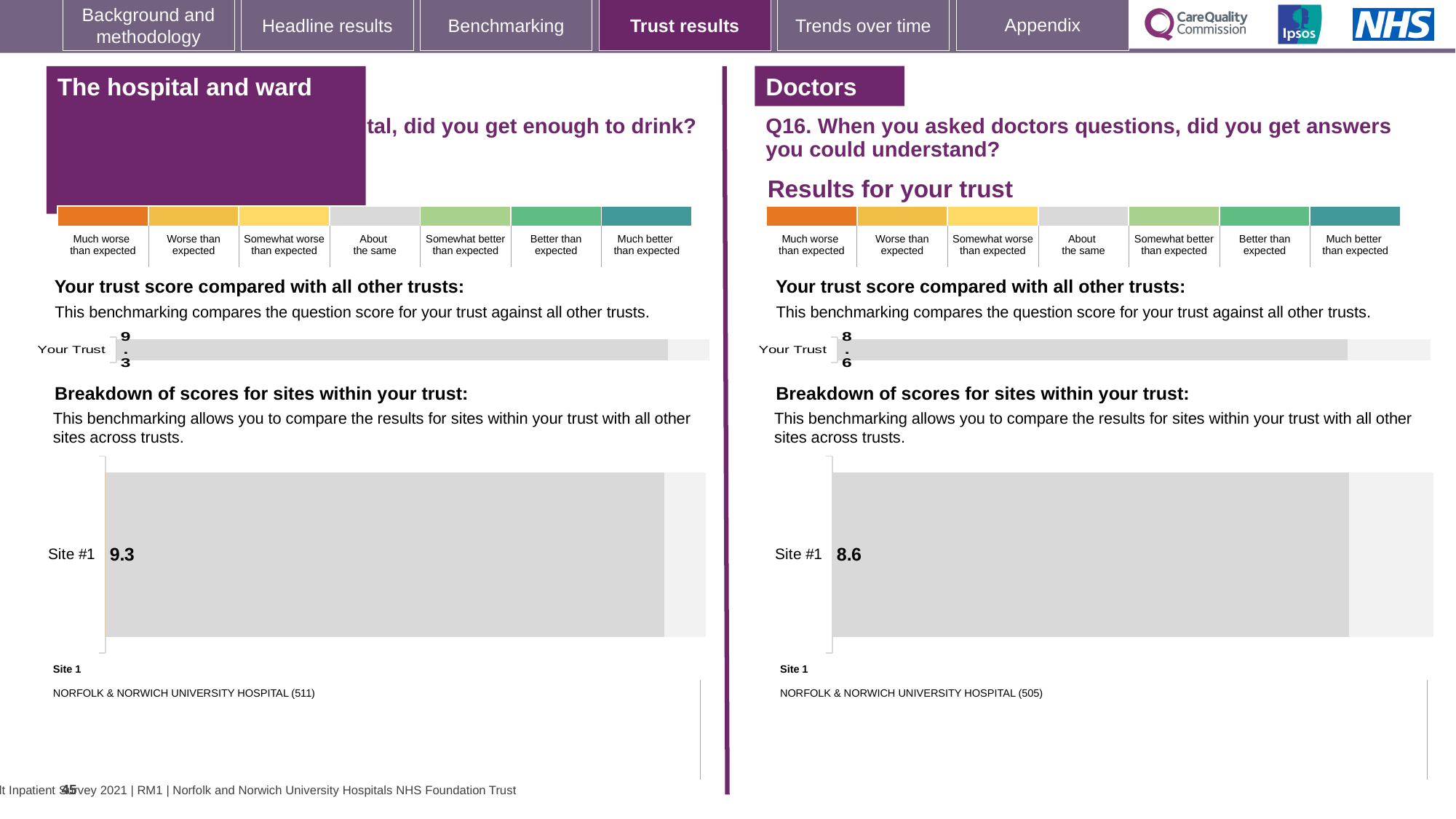
How many sites are shown in the left panel's breakdown of scores for sites chart? 1 Which panel shows the higher 'Your Trust' score: the left (The hospital and ward) or the right (Doctors, Q16)? The left (The hospital and ward), 9.3 How many categories does the colour scale above each chart show, from 'Much worse than expected' to 'Much better than expected'? 7 In the left panel's breakdown of scores for sites chart, what is the score for Site #1? 9.3 What is the difference between the 'Your Trust' score on the left panel and the 'Your Trust' score on the right panel (Q16)? 0.7 How many sites are shown in the right panel's (Q16) breakdown of scores for sites chart? 1 On the left panel (The hospital and ward), what is the 'Your Trust' score shown in the trust comparison bar chart? 9.3 On the right panel (Doctors, Q16), what is the 'Your Trust' score shown in the trust comparison bar chart? 8.6 In the right panel's (Q16) breakdown of scores for sites chart, what is the score for Site #1? 8.6 What type of chart is used to show the 'Your Trust' score on each panel? Bar chart In the right panel (Q16), is the Site #1 score equal to the 'Your Trust' score? Yes, both are 8.6 Which hospital is listed as Site 1 in the left panel's site breakdown? NORFOLK & NORWICH UNIVERSITY HOSPITAL (511)